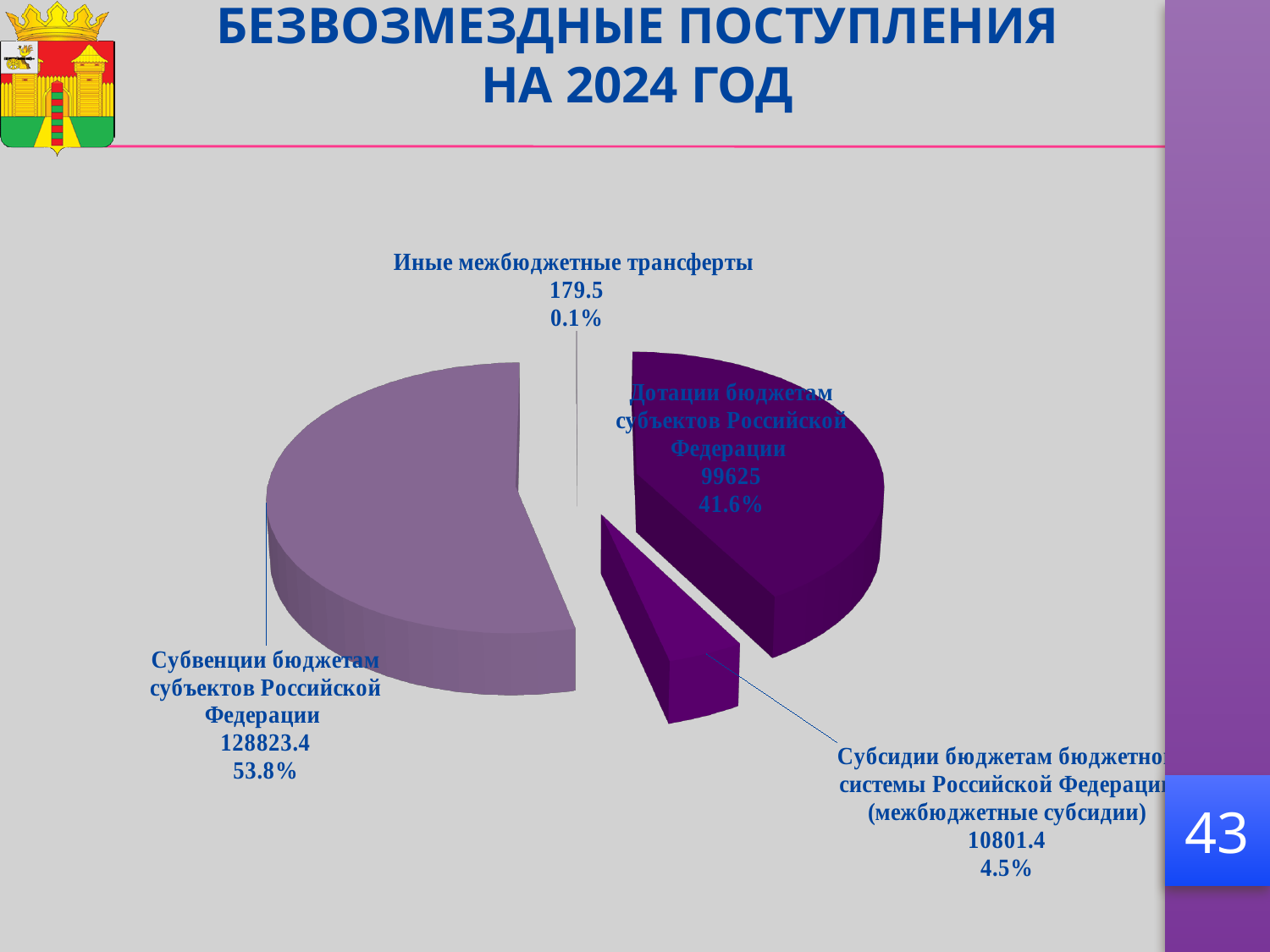
Which category has the largest share of the pie? Субвенции бюджетам субъектов Российской Федерации What is the value for Дотации бюджетам субъектов Российской Федерации? 99625 What kind of chart is shown on the slide? pie chart How many slices does the pie chart have? 4 What share of the pie does Дотации бюджетам субъектов Российской Федерации represent? 41.6% Which category has the smallest share of the pie? Иные межбюджетные трансферты What is the title of the chart on the slide? БЕЗВОЗМЕЗДНЫЕ ПОСТУПЛЕНИЯ НА 2024 ГОД What is the difference between the values for Субвенции бюджетам субъектов Российской Федерации and Дотации бюджетам субъектов Российской Федерации? 29198.4 What is the value for Субсидии бюджетам бюджетной системы Российской Федерации (межбюджетные субсидии)? 10801.4 What is the value for Иные межбюджетные трансферты? 179.5 What is the value for Субвенции бюджетам субъектов Российской Федерации? 128823.4 What share of the pie does Субсидии бюджетам бюджетной системы Российской Федерации (межбюджетные субсидии) represent? 4.5%